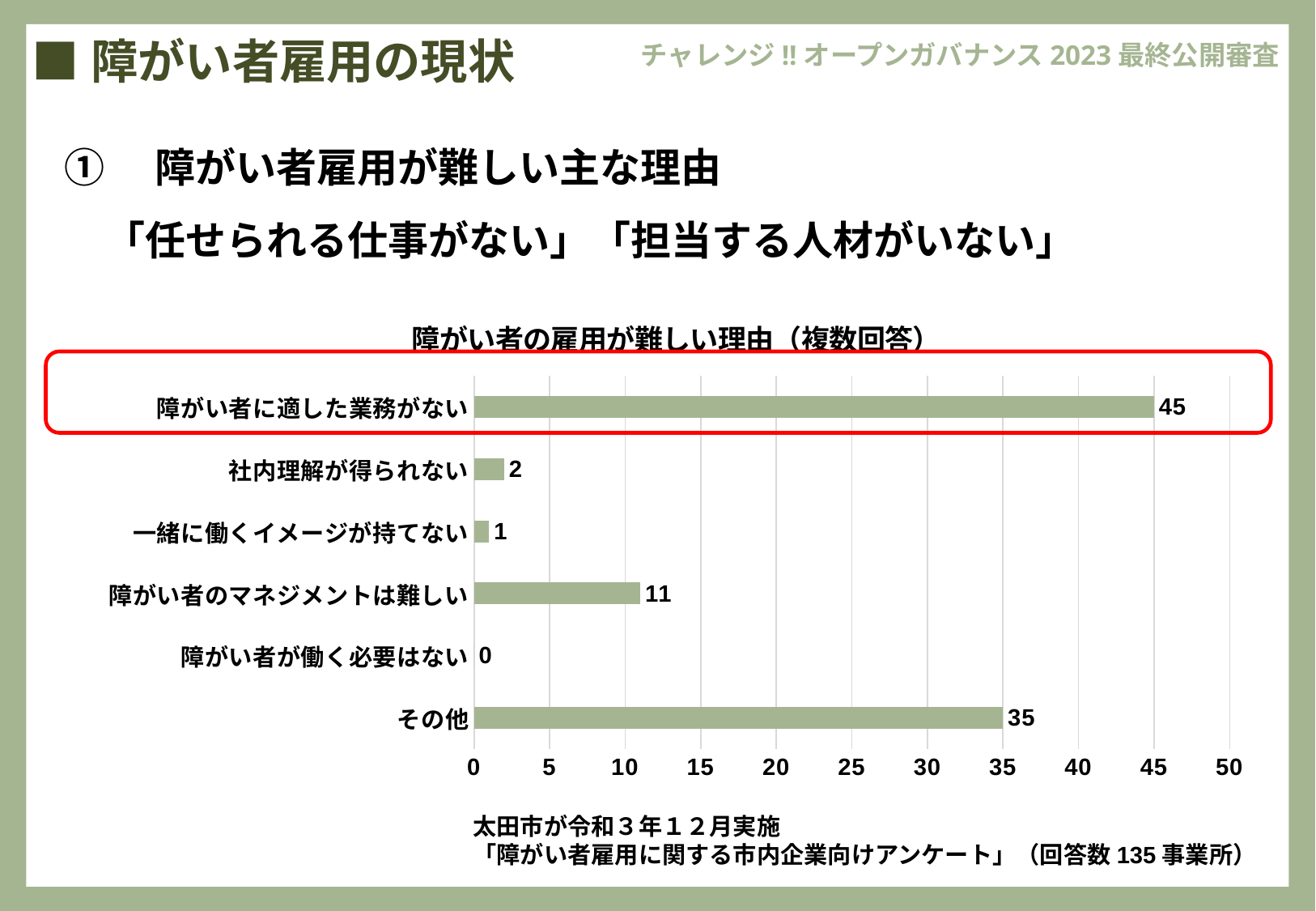
Which is larger, the value for 障がい者のマネジメントは難しい or the value for 社内理解が得られない? 障がい者のマネジメントは難しい What is the value for 社内理解が得られない? 2 What is the value for 障がい者のマネジメントは難しい? 11 Which category has the highest value? 障がい者に適した業務がない How many categories are shown in the chart? 6 Which category has the lowest value? 障がい者が働く必要はない What is the maximum value shown on the x axis? 50 What is the value for 障がい者に適した業務がない? 45 What is the value for その他? 35 What is the title of the chart? 障がい者の雇用が難しい理由（複数回答） What kind of chart is this? bar chart What is the difference between the values for 障がい者に適した業務がない and その他? 10